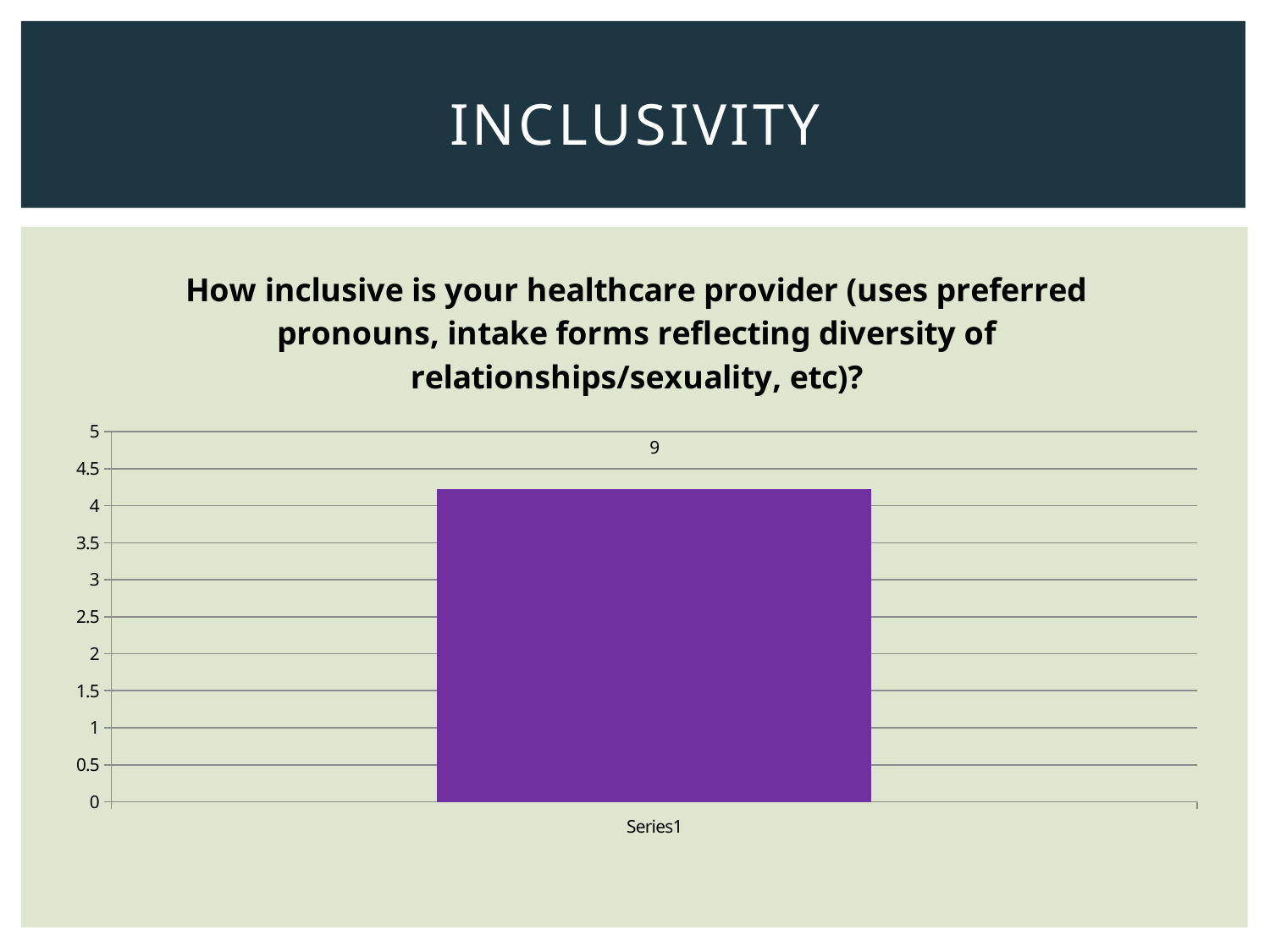
What number is printed as the data label above the bar? 9 What is the category label shown on the x axis of the chart? Series1 Is the value of the Series1 bar greater or less than 2? greater What is the highest value shown on the chart's y axis? 5 Is the value of the Series1 bar greater or less than 4.5? less How many bars does the chart show? 1 What kind of chart is shown on the slide? bar chart Is the value of the Series1 bar greater or less than 4? greater